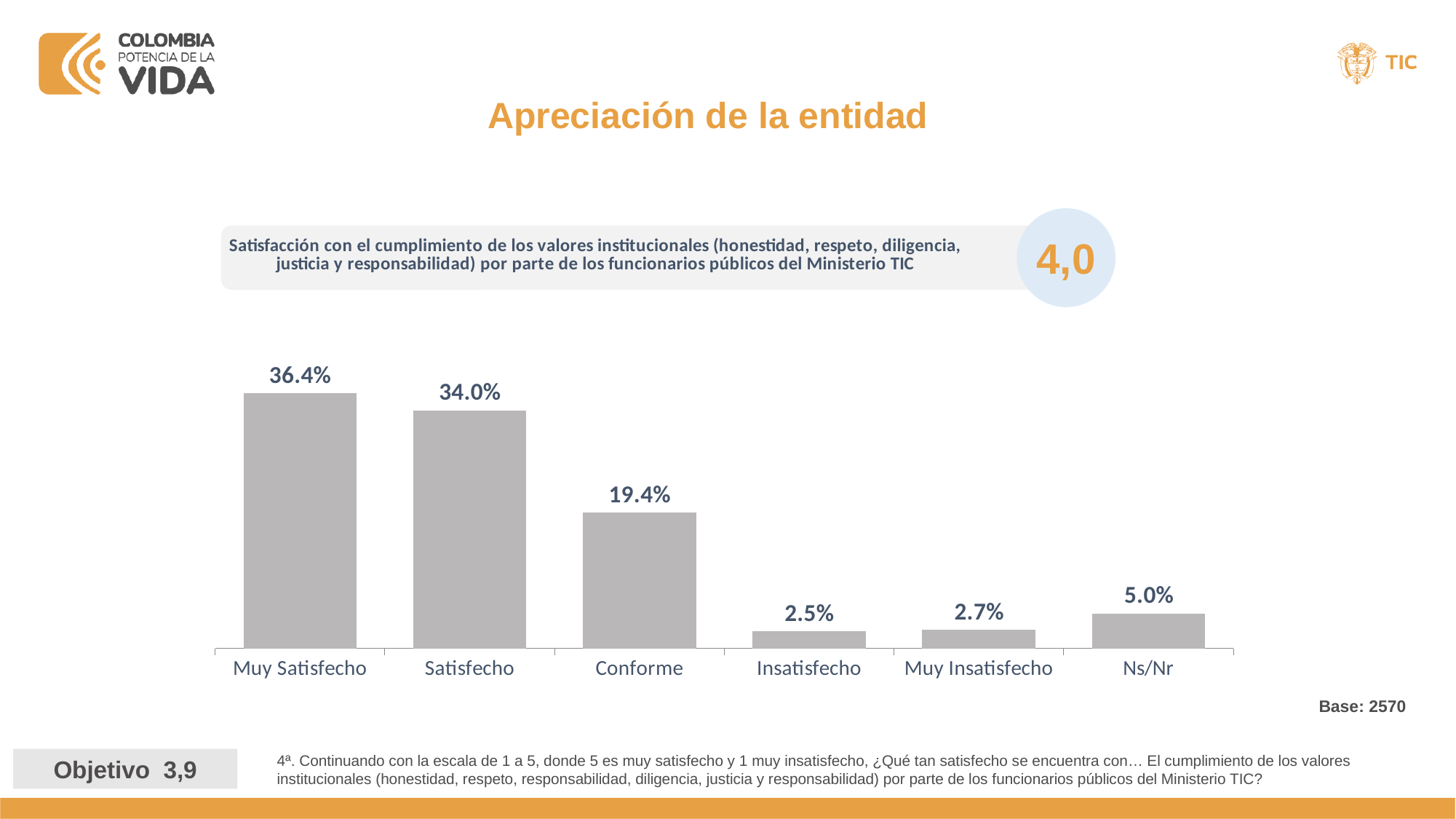
What is the base (number of respondents) shown on the slide? 2570 What is the value for Muy Satisfecho? 36.4% What is the combined value of Muy Satisfecho and Satisfecho? 70.4% What kind of chart is shown on the slide? bar chart Which category has the highest value? Muy Satisfecho Which is larger, the value for Insatisfecho or the value for Muy Insatisfecho? Muy Insatisfecho How many categories are shown on the x axis of the chart? 6 Which category has the lowest value? Insatisfecho What is the difference between the values for Muy Satisfecho and Satisfecho? 2.4% What is the difference between the values for Satisfecho and Conforme? 14.6% What is the value for Ns/Nr? 5.0% What is the value for Conforme? 19.4%